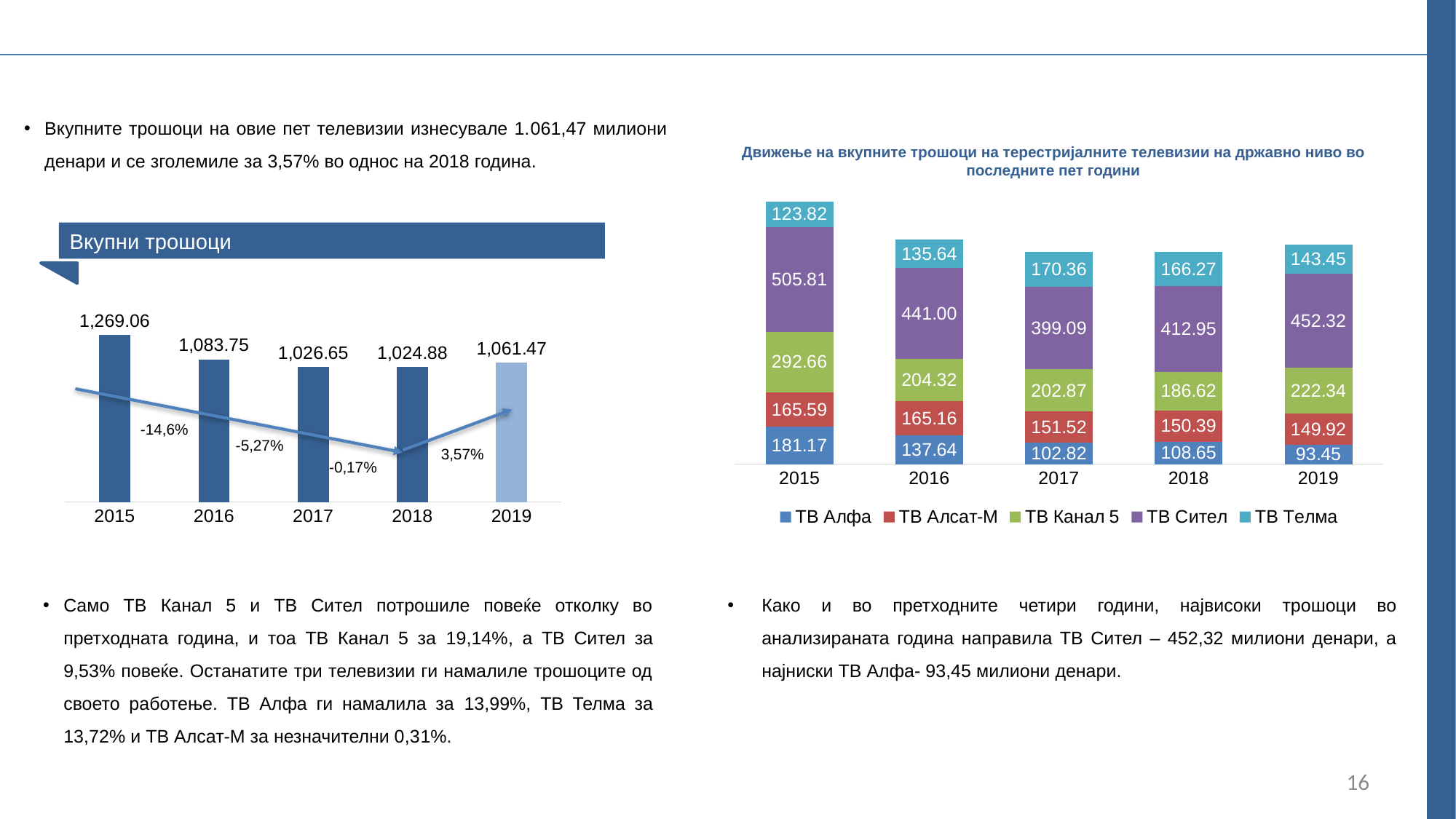
In the 'Вкупни трошоци' chart, which year has the highest value? 2015 In the 'Вкупни трошоци' chart, what is the difference between the values for 2015 and 2016? 185.31 What type of chart is the chart on the right? Stacked bar chart In the 'Вкупни трошоци' chart, what percentage change is labelled between 2018 and 2019? 3,57% In the stacked chart on the right, how many series does the legend list? 5 In the stacked chart on the right, which is larger in 2016: ТВ Канал 5 or ТВ Телма? ТВ Канал 5 In the 'Вкупни трошоци' chart, what is the value for 2019? 1,061.47 In the stacked chart on the right, what is the difference between ТВ Сител and ТВ Алфа in 2019? 358.87 In the stacked chart on the right, what is the value for ТВ Сител in 2019? 452.32 In the 'Вкупни трошоци' chart, which year has the lowest value? 2018 In the stacked chart on the right, what is the value for ТВ Алфа in 2017? 102.82 In the 'Вкупни трошоци' chart, how many years are shown on the x axis? 5